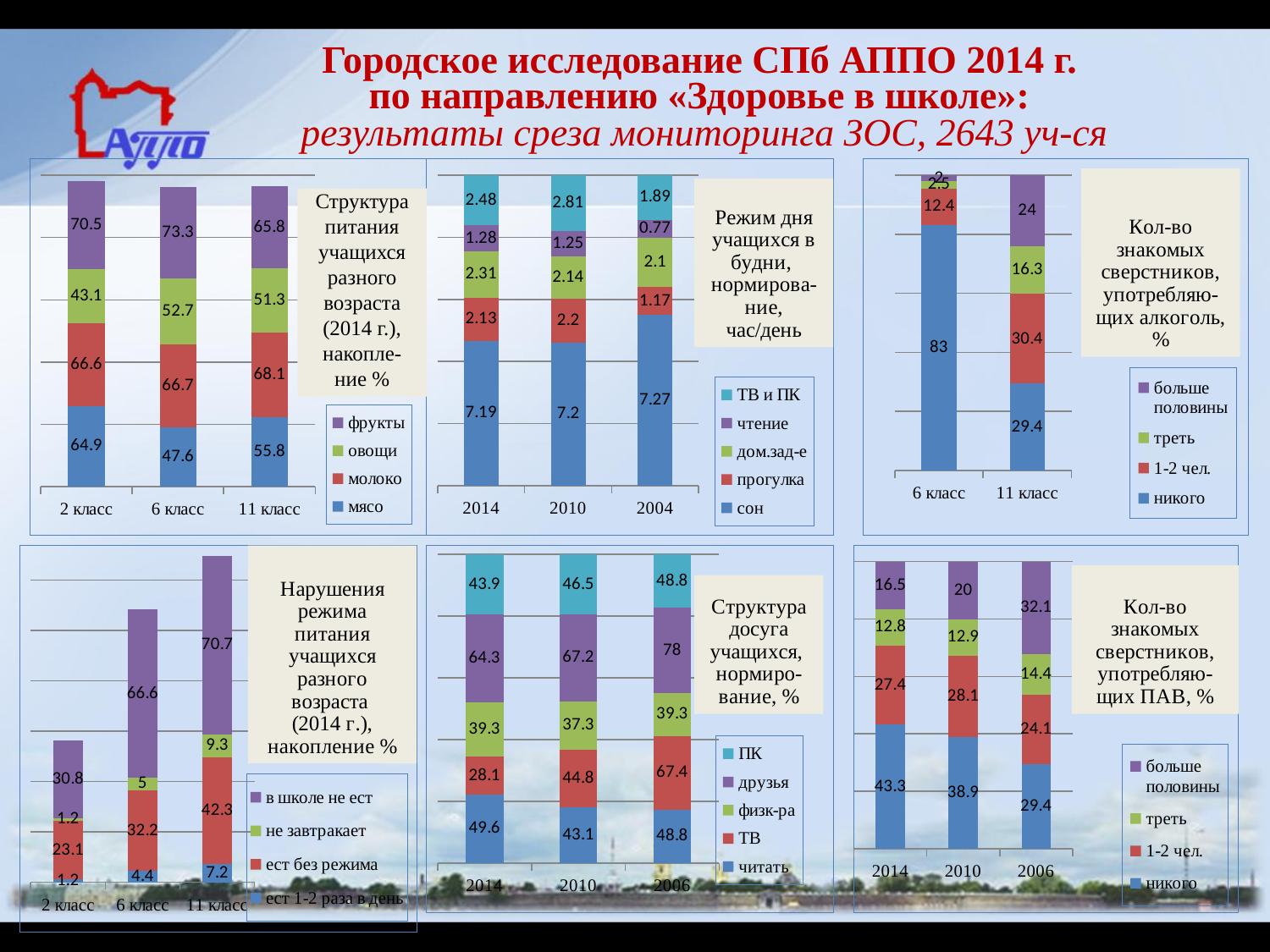
On the chart 'Нарушения режима питания учащихся разного возраста (2014 г.), накопление %', how many categories are shown on the x axis? 3 On the chart 'Режим дня учащихся в будни, нормирование, час/день', what is the difference between the ТВ и ПК values for 2010 and 2004? 0.92 On the chart 'Режим дня учащихся в будни, нормирование, час/день', how many series does the legend list? 5 On the chart 'Структура досуга учащихся, нормирование, %', what is the value for друзья in 2006? 78 On the chart 'Структура питания учащихся разного возраста (2014 г.), накопление %', what is the value for мясо for 6 класс? 47.6 On the chart 'Кол-во знакомых сверстников, употребляющих алкоголь, %', which class has the larger value for никого, 6 класс or 11 класс? 6 класс On the chart 'Режим дня учащихся в будни, нормирование, час/день', what is the value for сон in 2004? 7.27 On the chart 'Структура питания учащихся разного возраста (2014 г.), накопление %', which class has the highest value for фрукты? 6 класс On the chart 'Нарушения режима питания учащихся разного возраста (2014 г.), накопление %', what is the value for в школе не ест for 11 класс? 70.7 On the chart 'Кол-во знакомых сверстников, употребляющих алкоголь, %', what is the value for никого for 11 класс? 29.4 On the chart 'Структура досуга учащихся, нормирование, %', which year has the lowest value for ТВ? 2014 What kind of chart is 'Кол-во знакомых сверстников, употребляющих ПАВ, %'? Stacked bar chart